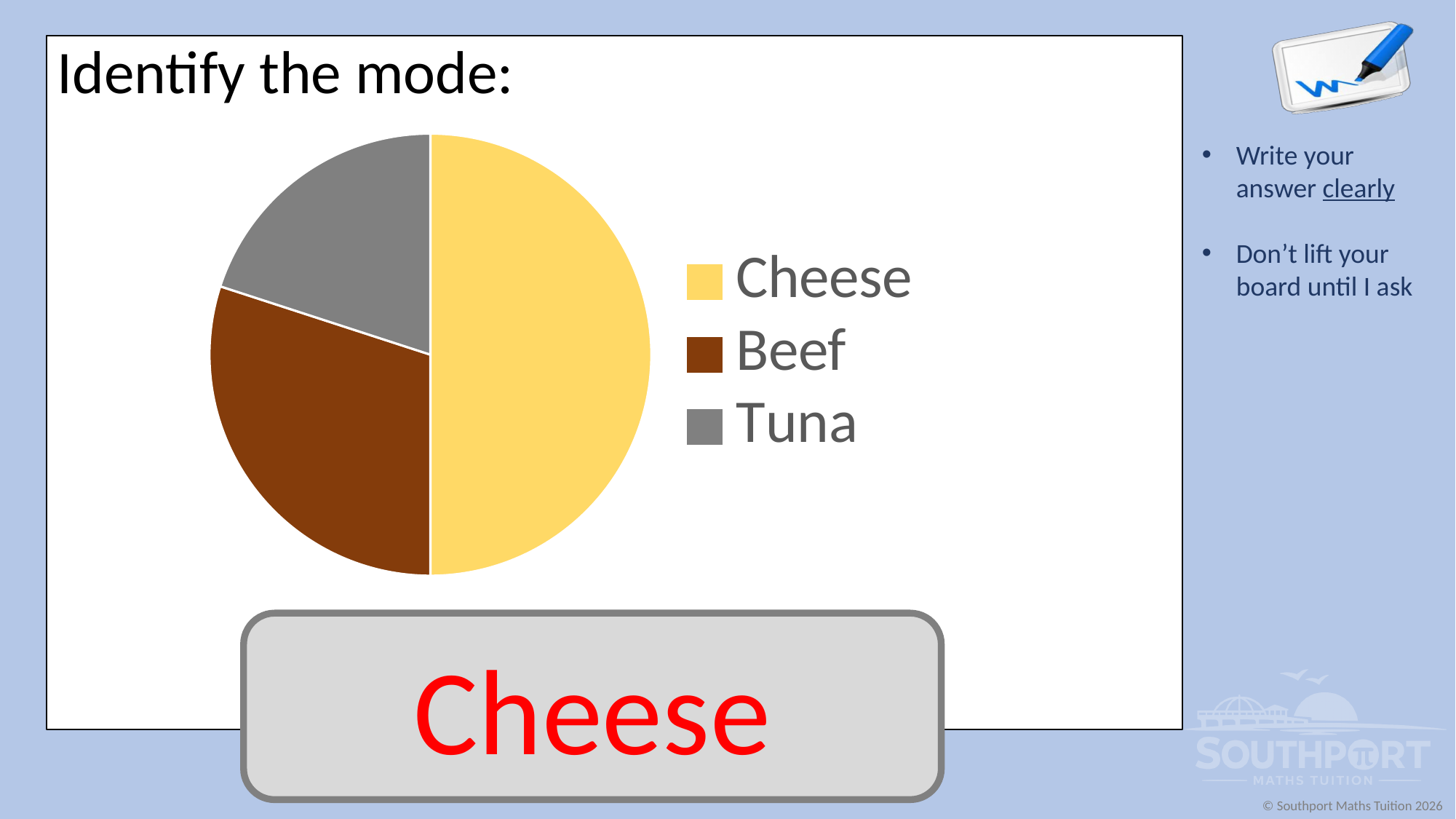
How many entries does the legend list? 3 Which category has the largest slice of the pie chart? Cheese Which slice is larger, Cheese or Tuna? Cheese How many slices does the pie chart have? 3 What colour is the Beef slice in the pie chart? brown Which slice is larger, Cheese or Beef? Cheese What kind of chart is shown on the slide? pie chart Which slice is larger, Beef or Tuna? Beef Which category has the smallest slice of the pie chart? Tuna According to the slide, what is the mode of the data shown in the pie chart? Cheese Which category is shown in grey in the pie chart? Tuna